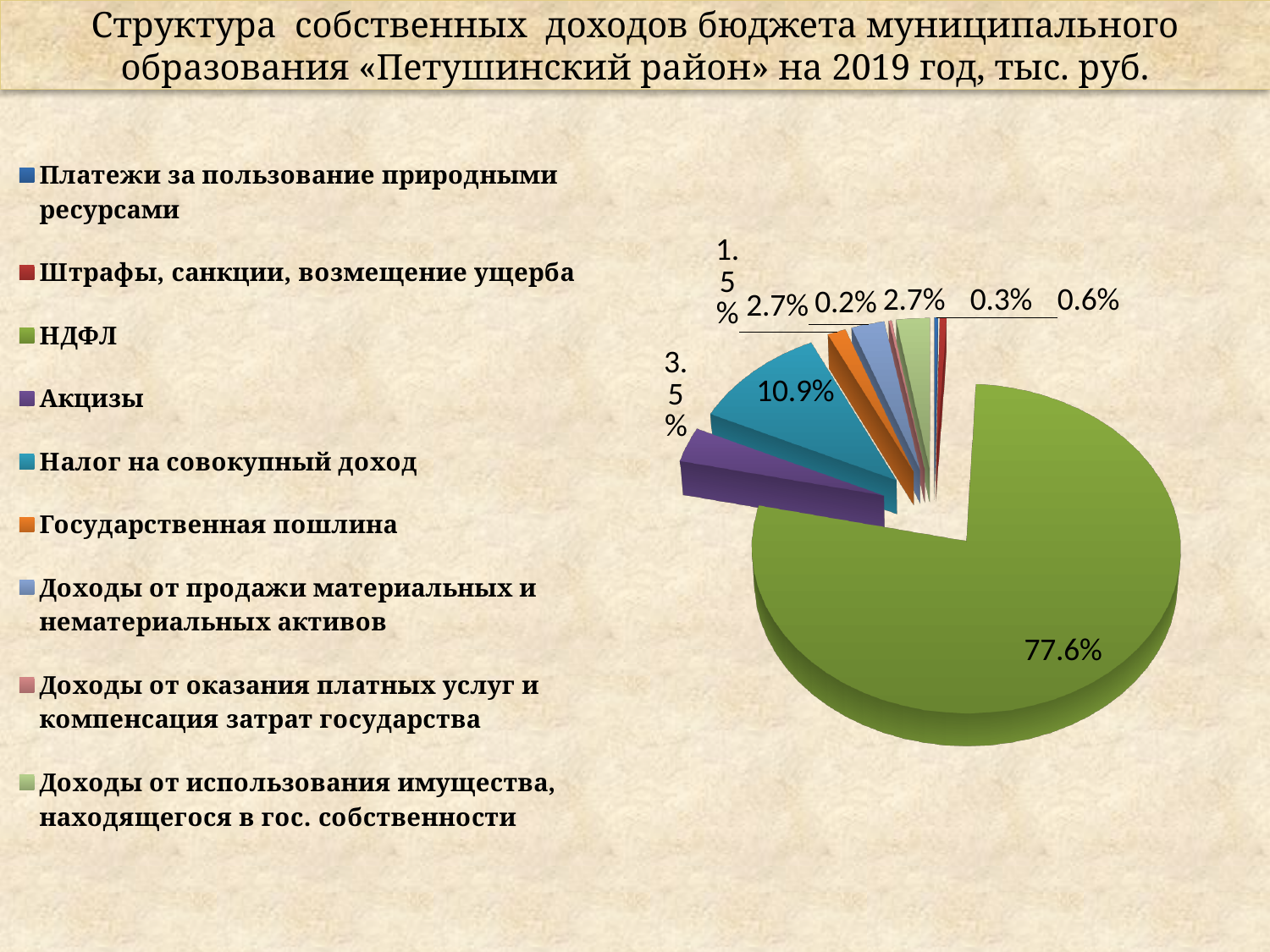
What colour is the slice representing НДФЛ? green How many categories does the legend list? 9 What is the smallest percentage labelled on the pie chart? 0.2% What is the difference in percentage points between the share for Налог на совокупный доход and the share for Акцизы? 7.4 Which category has the largest share of the pie? НДФЛ What share of the pie does НДФЛ account for? 77.6% What is the difference in percentage points between the share for НДФЛ and the share for Налог на совокупный доход? 66.7 What is the value shown for Налог на совокупный доход? 10.9% Which is larger, the share for Акцизы or the share for Налог на совокупный доход? Налог на совокупный доход What is the value shown for Акцизы? 3.5% What year does the chart title refer to? 2019 What kind of chart is shown on the slide? pie chart